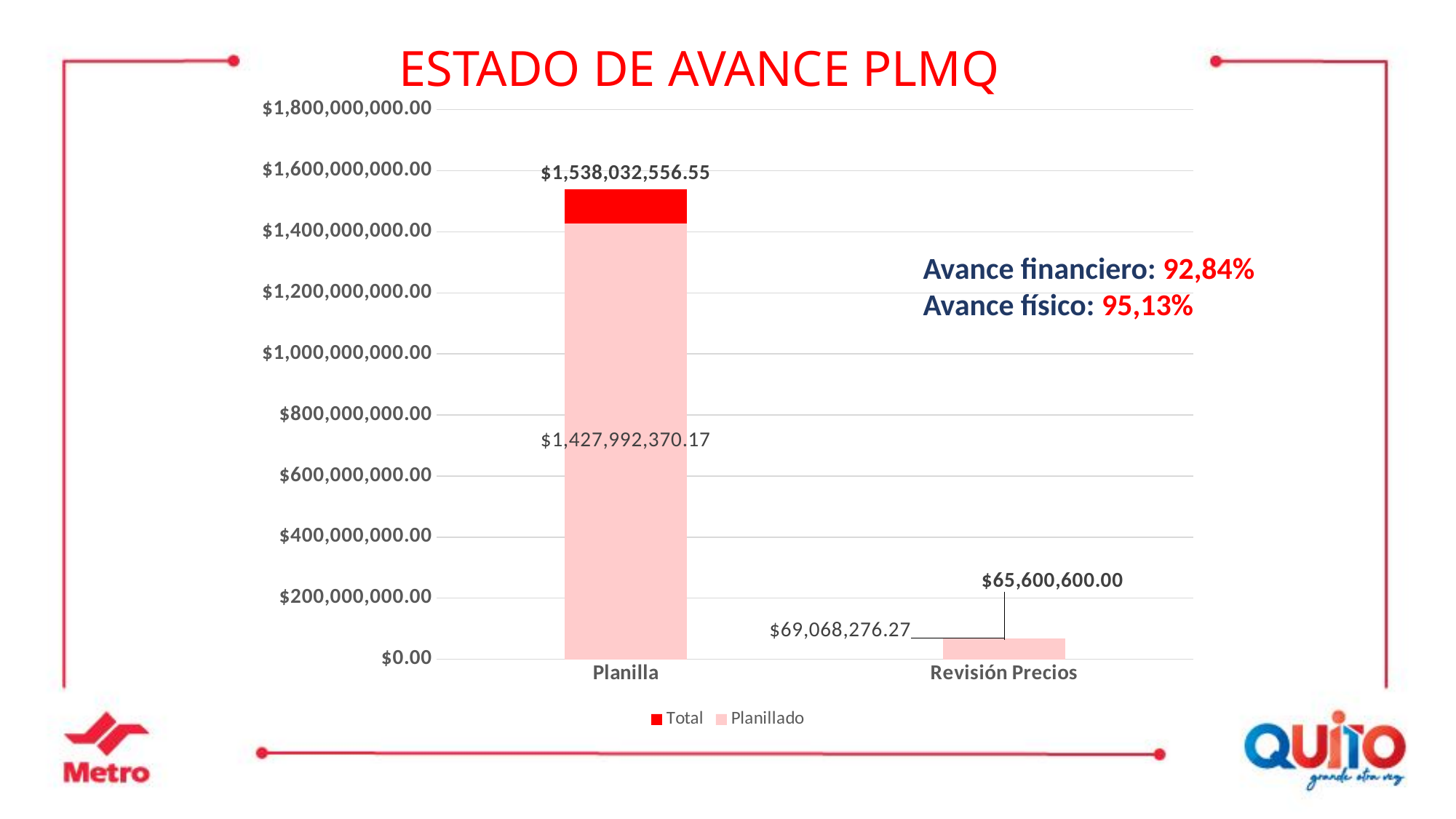
What type of chart is shown on the slide? Bar chart What is the difference between the Planillado and Total values for Revisión Precios? $3,467,676.27 What is the difference between the Total and Planillado values for Planilla? $110,040,186.38 What is the Planillado value for Revisión Precios? $69,068,276.27 How many categories are shown on the x axis? 2 Which category has the higher Total value? Planilla What is the Total value for Planilla? $1,538,032,556.55 What is the Total value for Revisión Precios? $65,600,600.00 What is the Planillado value for Planilla? $1,427,992,370.17 For Revisión Precios, which is larger: the Total value or the Planillado value? Planillado How many series does the legend list? 2 Which category has the lowest Planillado value? Revisión Precios